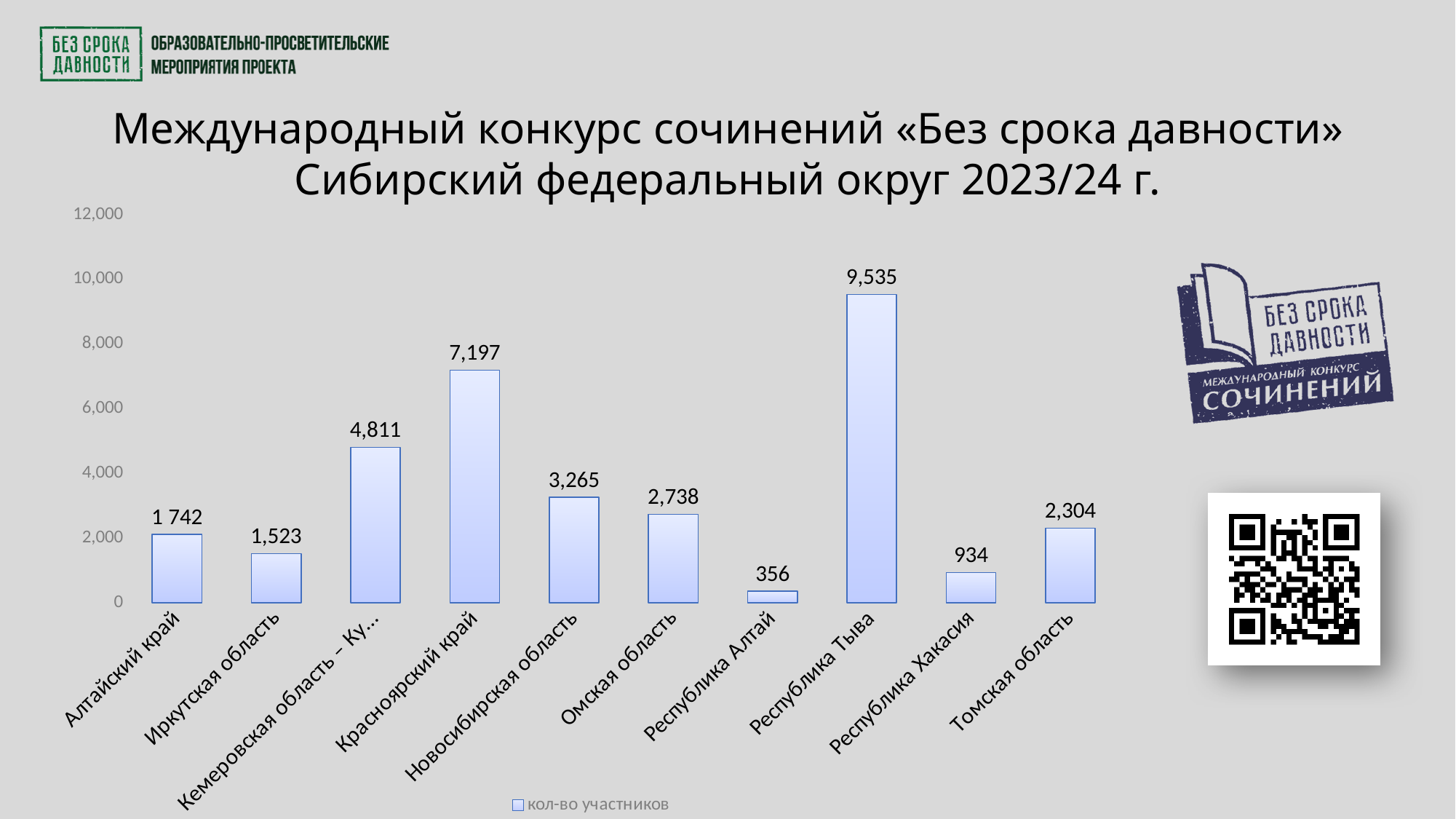
What kind of chart is shown on the slide? bar chart Which is larger, the value for Иркутская область or the value for Республика Хакасия? Иркутская область What is the difference between the values for Новосибирская область and Омская область? 527 What is the value for Республика Тыва? 9,535 Is the value for Красноярский край greater or less than 6,000? greater Which category has the lowest value? Республика Алтай How many categories are shown on the x axis? 10 What is the value for Томская область? 2,304 What is the value for Республика Алтай? 356 What series name does the legend show? кол-во участников What is the value for Красноярский край? 7,197 Which category has the highest value? Республика Тыва